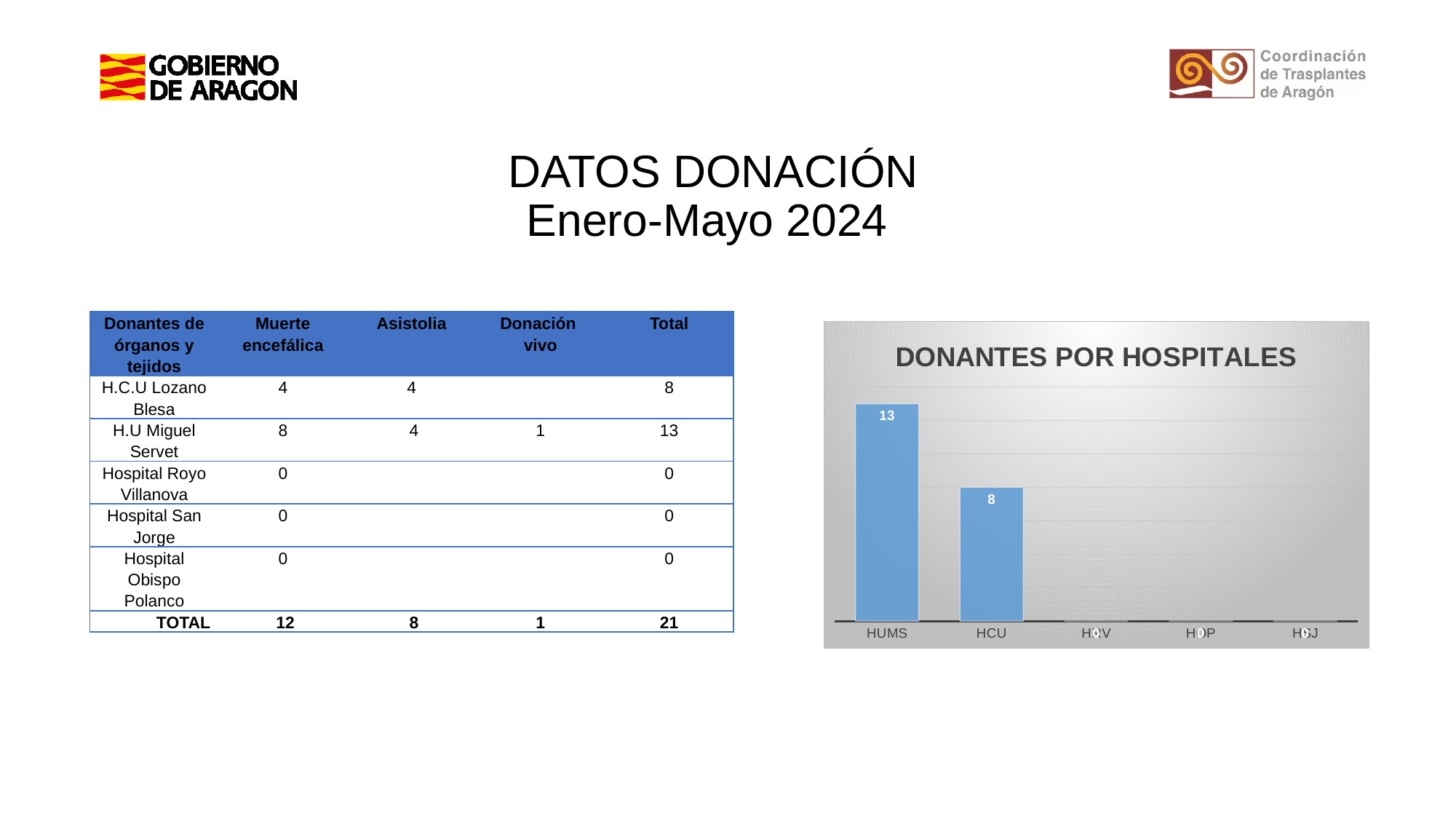
What is the value for HSJ in the chart? 0 Which hospital has the highest value in the chart? HUMS What is the title of the chart? DONANTES POR HOSPITALES What is the value for HRV in the chart? 0 What type of chart is shown on the slide? bar chart Which is larger, the value for HUMS or the value for HCU? HUMS What is the difference between the values for HUMS and HCU? 5 What is the value for HCU in the chart? 8 How many hospitals in the chart have a value of 0? 3 What is the value for HUMS in the chart? 13 How many hospitals are shown on the x axis of the chart? 5 What colour are the bars in the chart? blue